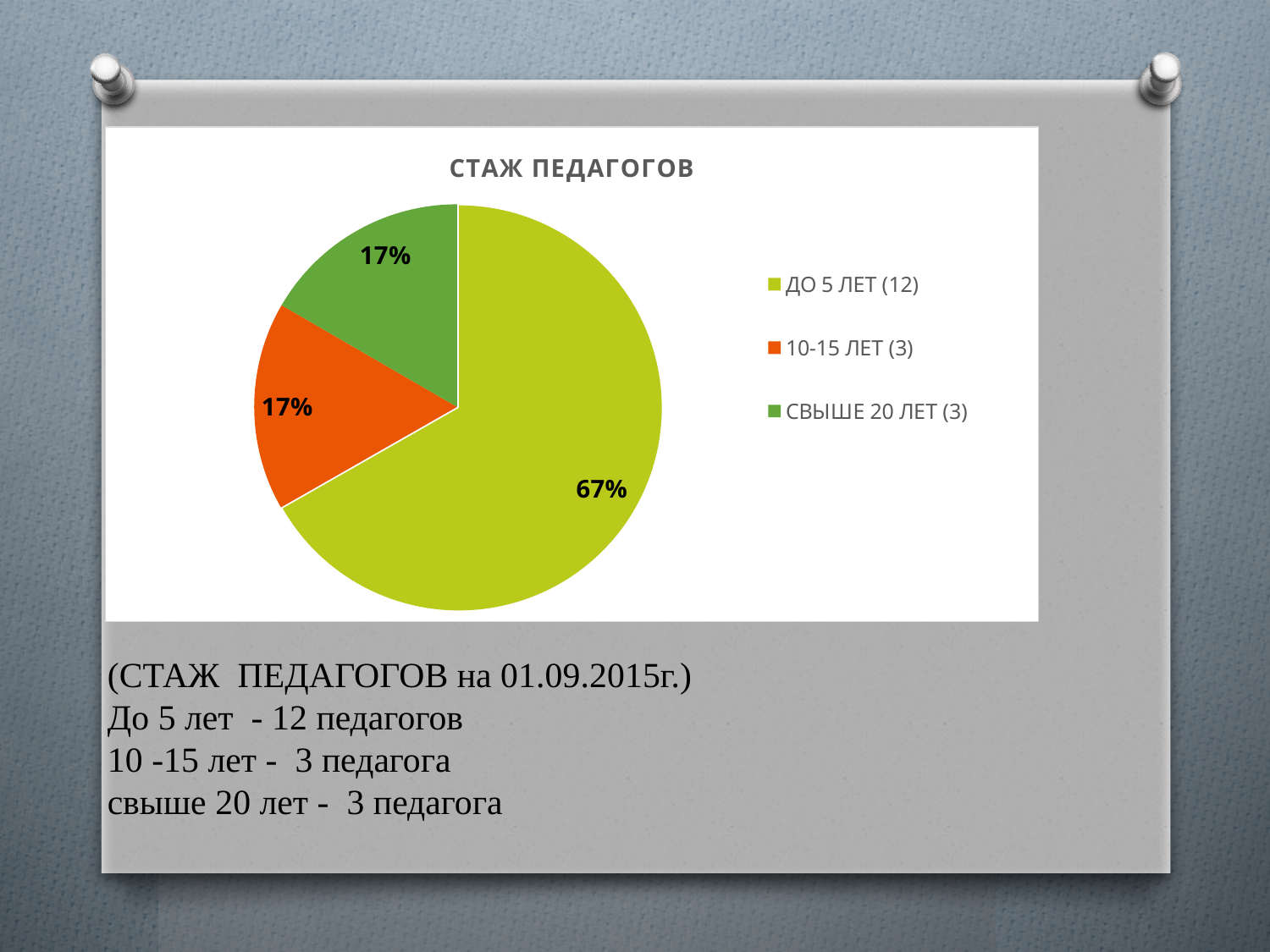
Which category has the largest slice of the pie? ДО 5 ЛЕТ (12) Is the share for 'ДО 5 ЛЕТ (12)' greater or less than 50%? greater What percentage share does the slice 'СВЫШЕ 20 ЛЕТ (3)' have? 17% What colour is the slice for '10-15 ЛЕТ (3)'? orange What percentage share does the slice 'ДО 5 ЛЕТ (12)' have? 67% What kind of chart is shown on the slide? pie chart How many entries does the legend list? 3 What is the difference in percentage points between the 'ДО 5 ЛЕТ (12)' slice and the '10-15 ЛЕТ (3)' slice? 50 How many slices does the pie chart have? 3 What percentage share does the slice '10-15 ЛЕТ (3)' have? 17% What is the title of the chart? СТАЖ ПЕДАГОГОВ Which is larger, the share for 'ДО 5 ЛЕТ (12)' or the share for 'СВЫШЕ 20 ЛЕТ (3)'? ДО 5 ЛЕТ (12)